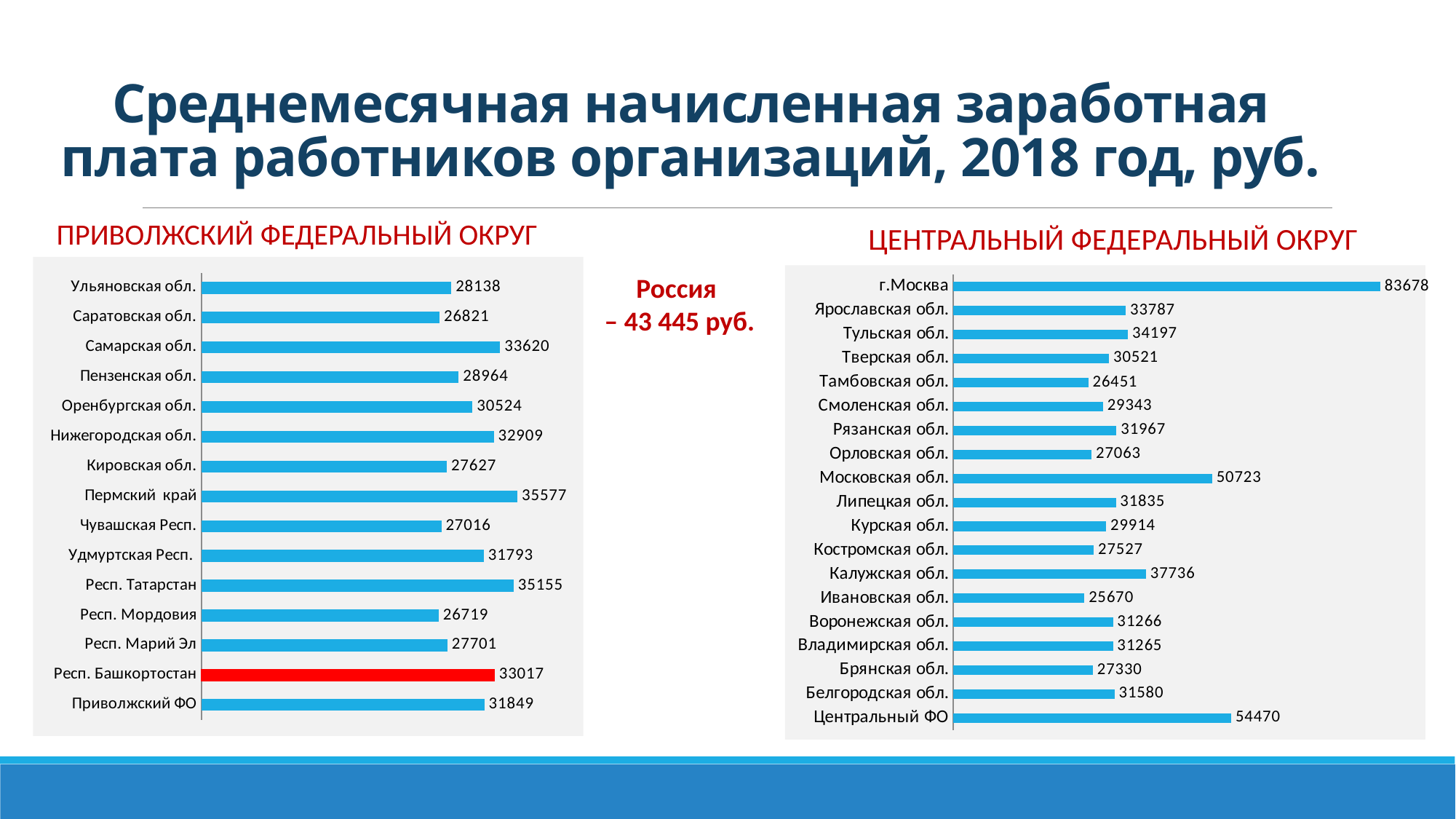
What type of chart is the ПРИВОЛЖСКИЙ ФЕДЕРАЛЬНЫЙ ОКРУГ chart? Bar chart On the ЦЕНТРАЛЬНЫЙ ФЕДЕРАЛЬНЫЙ ОКРУГ chart, what is the value for Калужская обл.? 37736 On the ЦЕНТРАЛЬНЫЙ ФЕДЕРАЛЬНЫЙ ОКРУГ chart, which is larger: Тульская обл. or Тверская обл.? Тульская обл. On the ПРИВОЛЖСКИЙ ФЕДЕРАЛЬНЫЙ ОКРУГ chart, which is larger: Самарская обл. or Нижегородская обл.? Самарская обл. On the ПРИВОЛЖСКИЙ ФЕДЕРАЛЬНЫЙ ОКРУГ chart, what is the difference between Респ. Башкортостан and Приволжский ФО? 1168 How many categories are shown on the ЦЕНТРАЛЬНЫЙ ФЕДЕРАЛЬНЫЙ ОКРУГ chart? 19 How many categories are shown on the ПРИВОЛЖСКИЙ ФЕДЕРАЛЬНЫЙ ОКРУГ chart? 15 On the ПРИВОЛЖСКИЙ ФЕДЕРАЛЬНЫЙ ОКРУГ chart, which category has the highest value? Пермский край On the ПРИВОЛЖСКИЙ ФЕДЕРАЛЬНЫЙ ОКРУГ chart, what is the value for Респ. Башкортостан? 33017 On the ЦЕНТРАЛЬНЫЙ ФЕДЕРАЛЬНЫЙ ОКРУГ chart, what is the difference between г.Москва and Московская обл.? 32955 On the ЦЕНТРАЛЬНЫЙ ФЕДЕРАЛЬНЫЙ ОКРУГ chart, which category has the highest value? г.Москва On the ЦЕНТРАЛЬНЫЙ ФЕДЕРАЛЬНЫЙ ОКРУГ chart, which category has the lowest value? Ивановская обл.